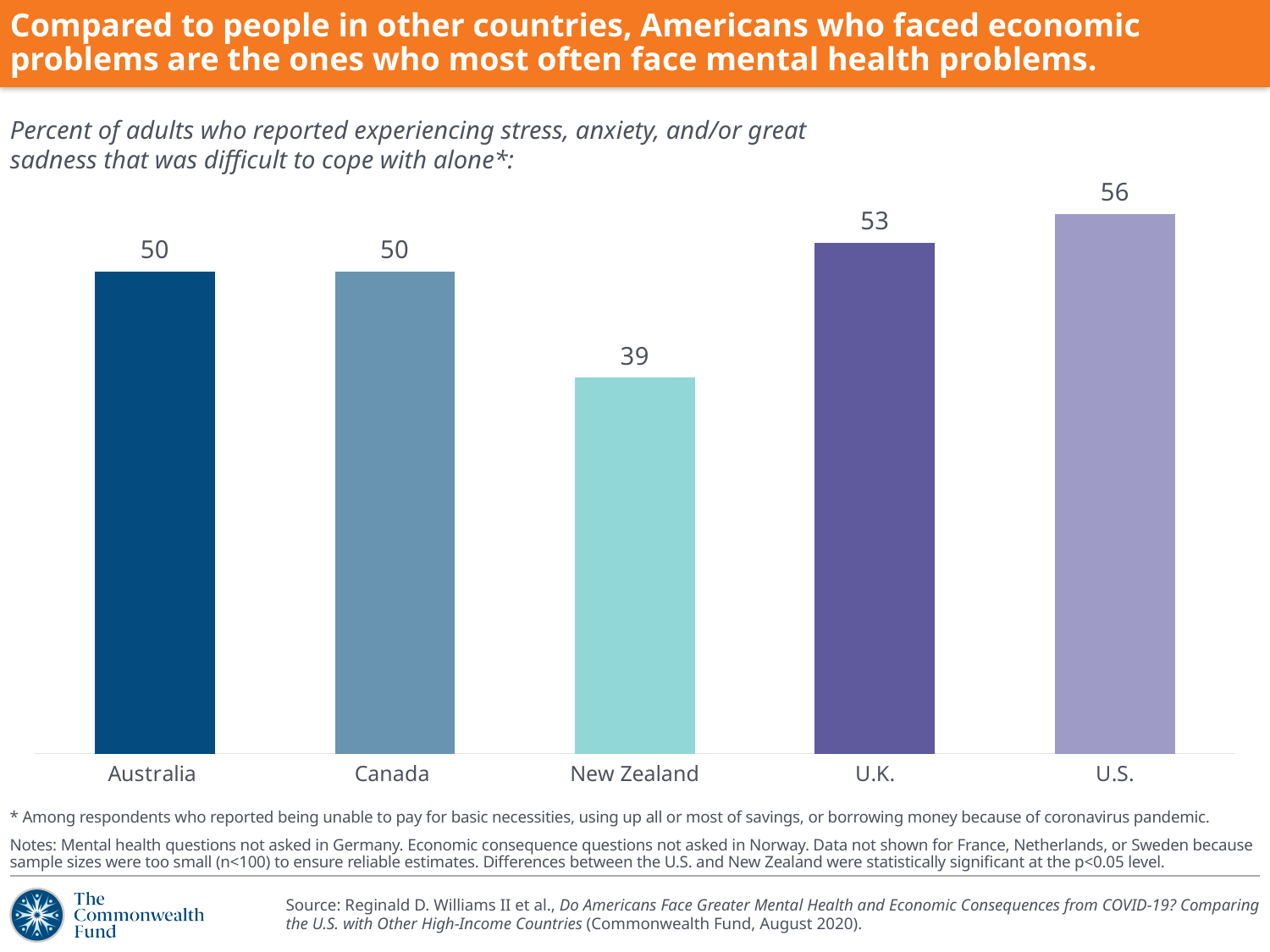
Which country has the lowest value? New Zealand What is the value for the U.K.? 53 What is the difference between the values for the U.S. and New Zealand? 17 What is the difference between the values for the U.K. and Australia? 3 What is the value for New Zealand? 39 How many countries are shown in the chart? 5 Which two countries have the same value? Australia and Canada Which is larger, the value for the U.K. or the value for Canada? U.K. What is the value for the U.S.? 56 What kind of chart is shown on the slide? Bar chart What is the value for Canada? 50 Which country has the highest value? U.S.